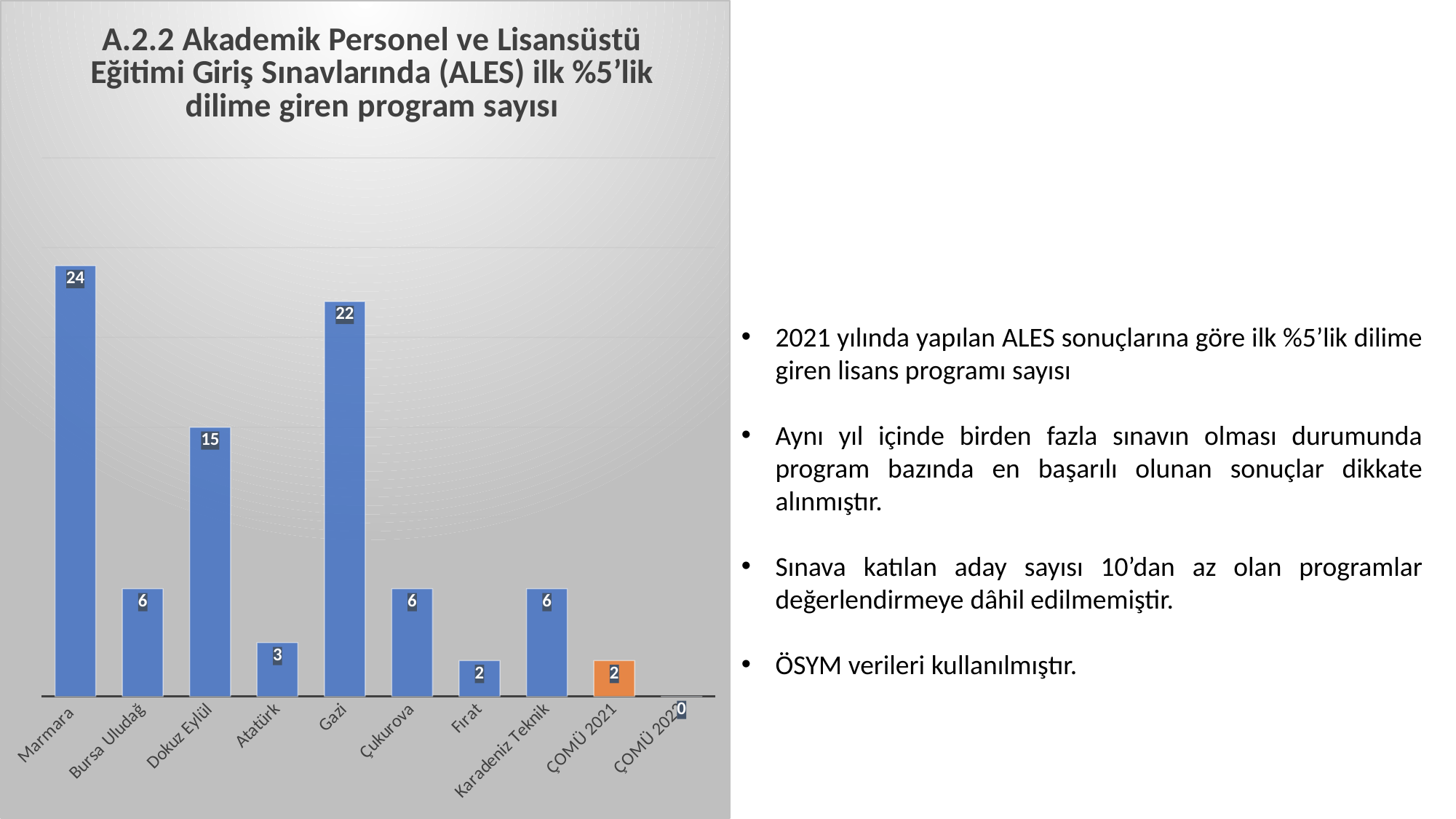
What is the difference between the values for Dokuz Eylül and Karadeniz Teknik? 9 What is the value for ÇOMÜ 2021? 2 Which category has the highest value? Marmara What is the value for Gazi? 22 What is the value for Marmara? 24 What is the difference between the values for Marmara and Gazi? 2 Which bar is coloured orange instead of blue? ÇOMÜ 2021 What is the value for Atatürk? 3 Which is larger, the value for Fırat or the value for Çukurova? Çukurova What kind of chart is shown on the slide? Bar chart How many categories are shown on the x axis? 10 What is the value for Dokuz Eylül? 15